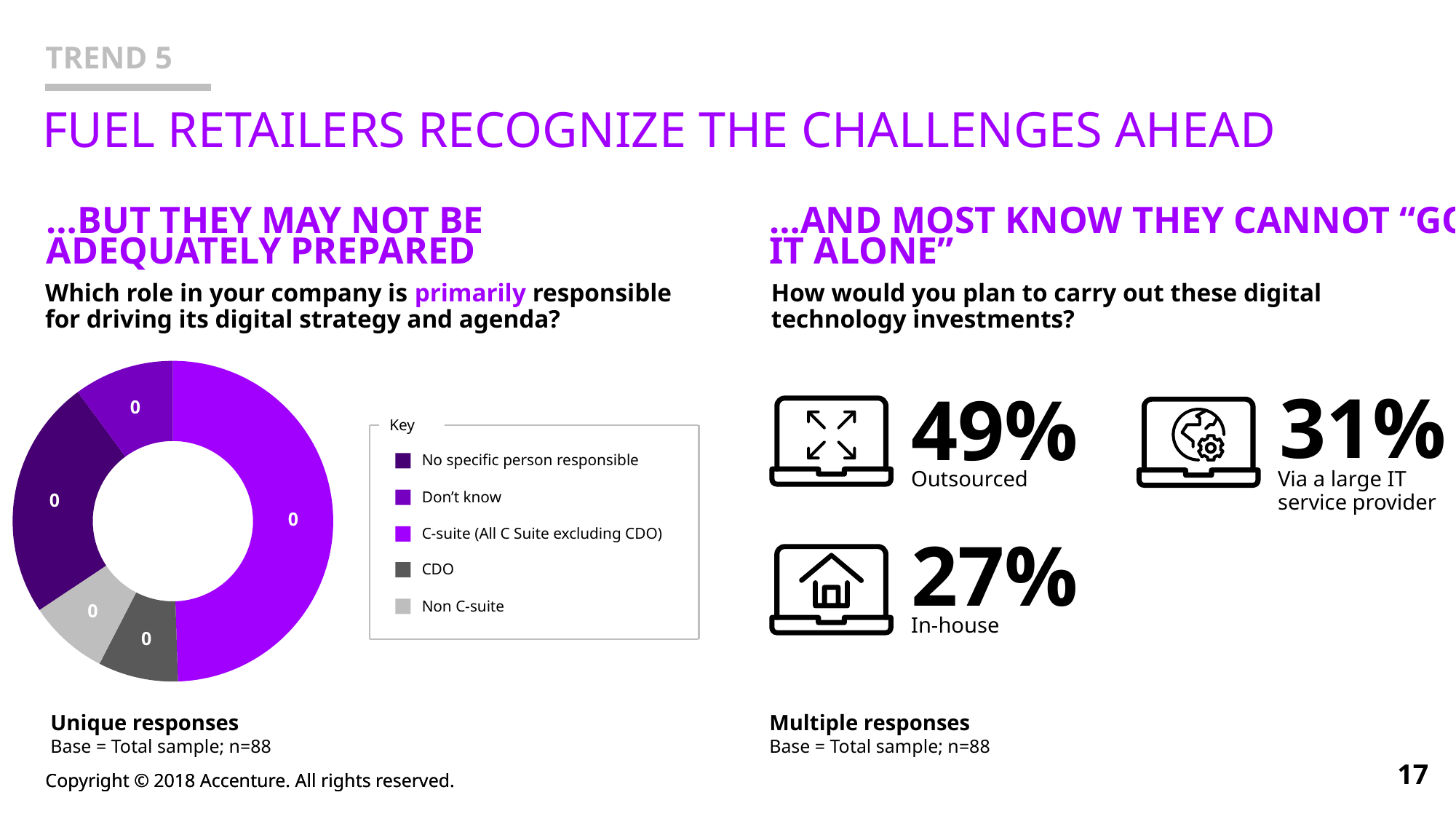
What is the title of the legend box next to the pie chart on the left? Key In the pie chart on the left, which slice is larger: C-suite (All C Suite excluding CDO) or Non C-suite? C-suite (All C Suite excluding CDO) In the pie chart on the left, which slice is larger: No specific person responsible or CDO? No specific person responsible In the pie chart on the left, which category has the largest slice? C-suite (All C Suite excluding CDO) In the key of the pie chart on the left, which category is shown in light grey? Non C-suite What is the base sample size (n) stated below the pie chart on the left? n=88 What kind of chart is shown on the left side of the slide under the question about which role is responsible for digital strategy? Pie chart (donut) In the pie chart on the left, which slice is larger: C-suite (All C Suite excluding CDO) or No specific person responsible? C-suite (All C Suite excluding CDO) How many categories does the key of the pie chart on the left list? 5